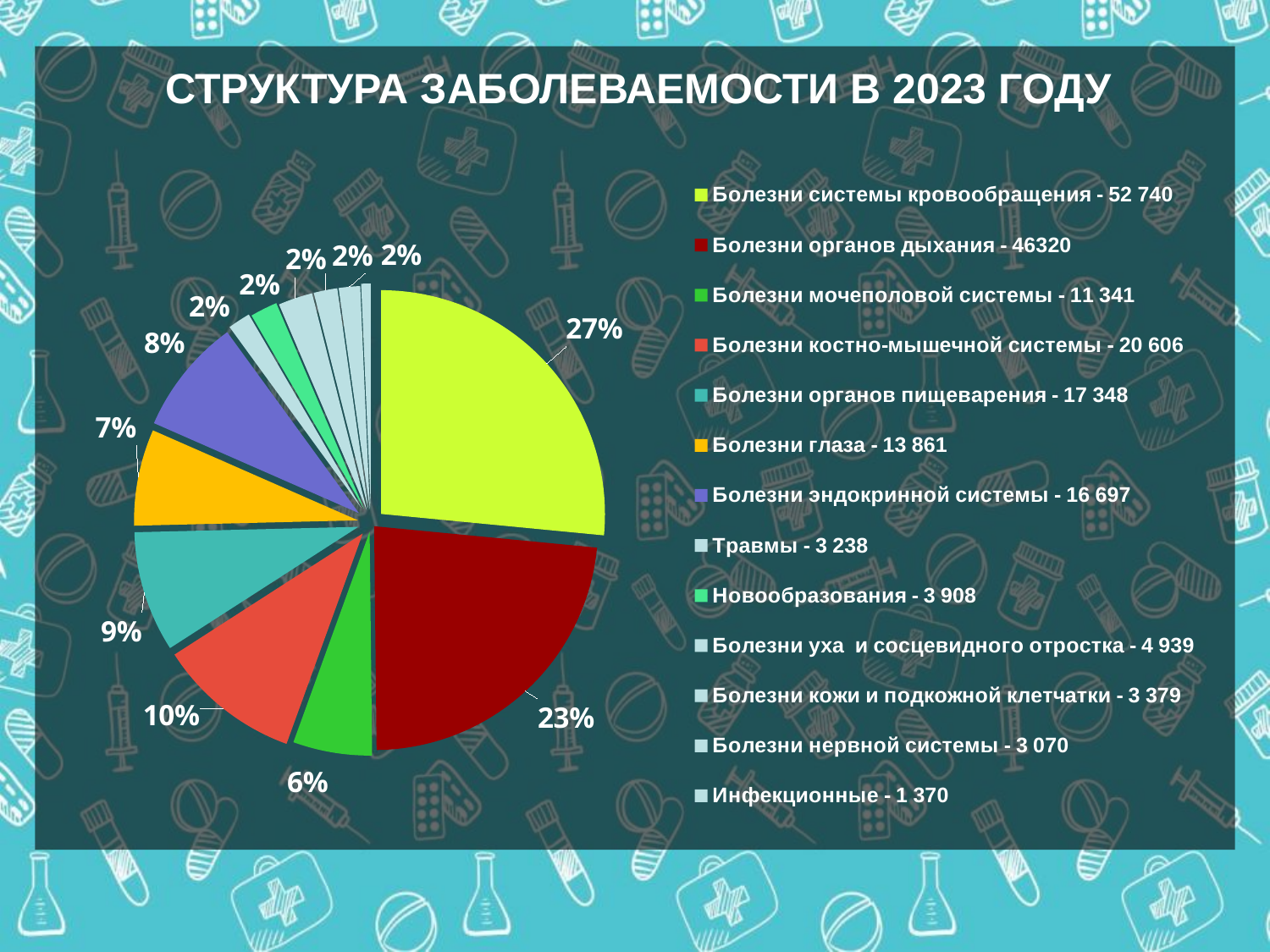
Which category has the smallest value in the legend? Инфекционные What kind of chart is shown on the slide? pie chart What value is given in the legend for Болезни системы кровообращения? 52 740 What share of the pie does Болезни органов дыхания take? 23% What value is given in the legend for Болезни глаза? 13 861 What value is given in the legend for Травмы? 3 238 How many categories does the legend list? 13 Which category has the largest share of the pie? Болезни системы кровообращения What share of the pie does Болезни костно-мышечной системы take? 10% What is the title of the chart? СТРУКТУРА ЗАБОЛЕВАЕМОСТИ В 2023 ГОДУ What is the difference between the legend values for Болезни системы кровообращения and Болезни органов дыхания? 6 420 Which is larger: Болезни органов пищеварения or Болезни эндокринной системы? Болезни органов пищеварения